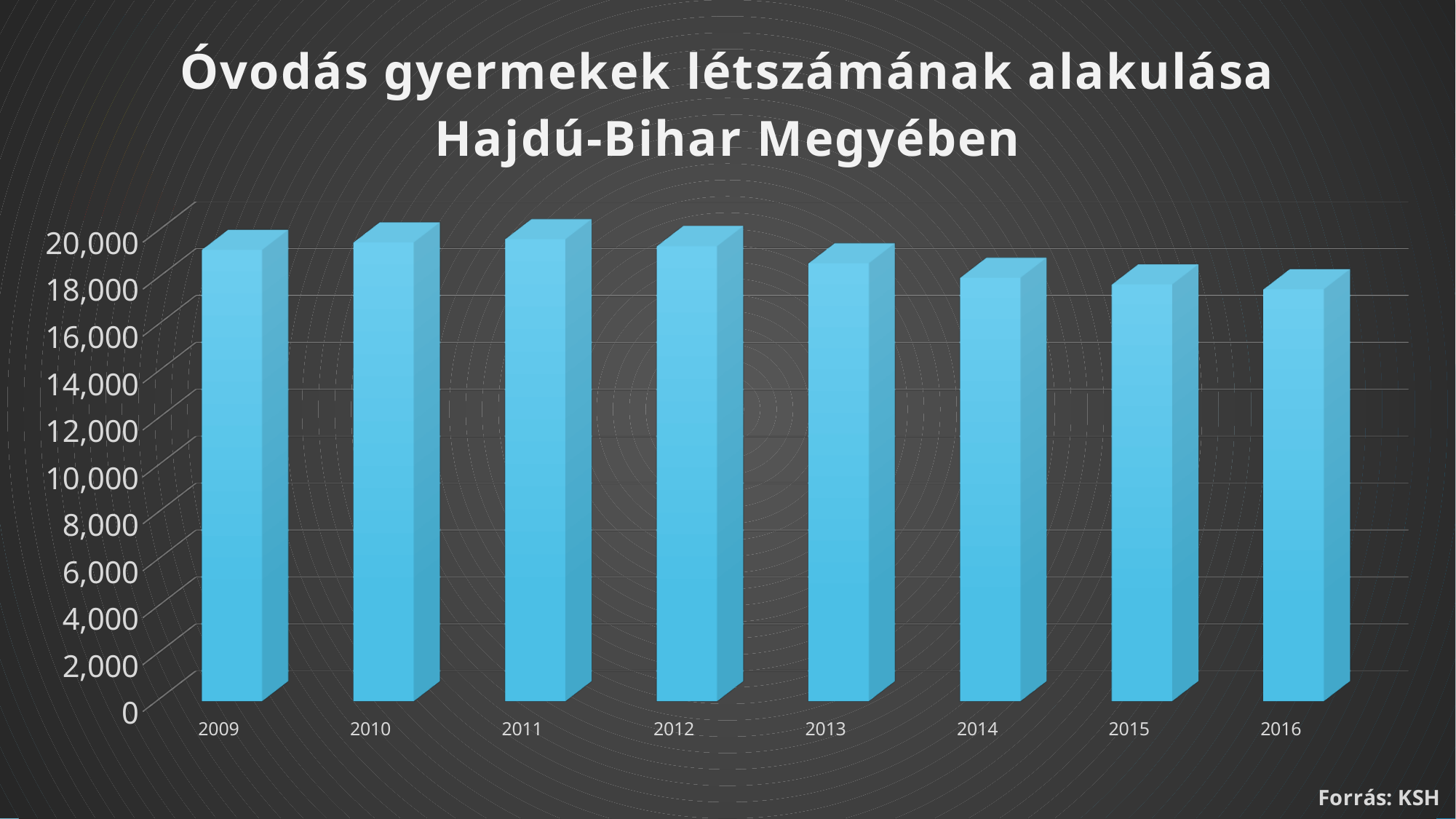
Is the value for 2016 greater or less than 20,000? less Which is larger, the value for 2011 or the value for 2014? 2011 How many years are shown on the x axis of the chart? 8 Is the value for 2009 greater or less than 16,000? greater What source is cited for the chart data? KSH Is the value for 2014 greater or less than 20,000? less Which is larger, the value for 2009 or the value for 2016? 2009 Do the values rise or fall from 2011 to 2016? fall Which year has the lowest number of kindergarten children in the chart? 2016 What is the title of the chart? Óvodás gyermekek létszámának alakulása Hajdú-Bihar Megyében What kind of chart is shown on the slide? bar chart